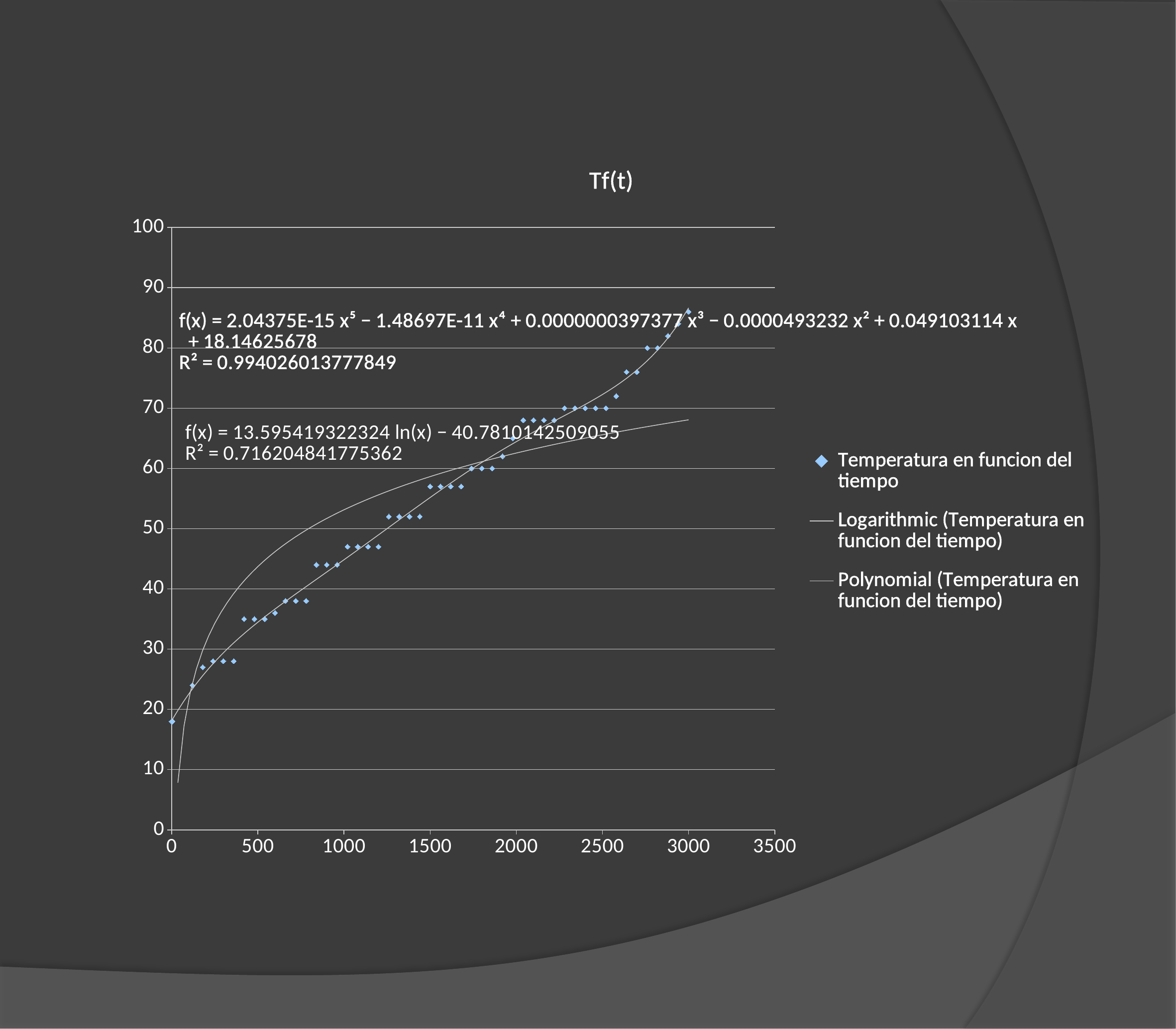
At x = 3000, which trendline reaches the higher value, the polynomial or the logarithmic? polynomial What is the R² value shown for the logarithmic trendline? 0.716204841775362 Is the temperature value at x = 500 greater or less than 30? greater Is the temperature value at x = 3000 greater or less than 80? greater Which trendline has the higher R² value, the polynomial or the logarithmic? polynomial Is the temperature value at x = 1000 greater or less than 40? greater How many entries does the chart legend list? 3 What is the title of the chart? Tf(t) What is the R² value shown for the polynomial trendline? 0.994026013777849 What kind of chart is shown on the slide? scatter chart Do the plotted temperature values rise or fall as time increases along the x axis? rise